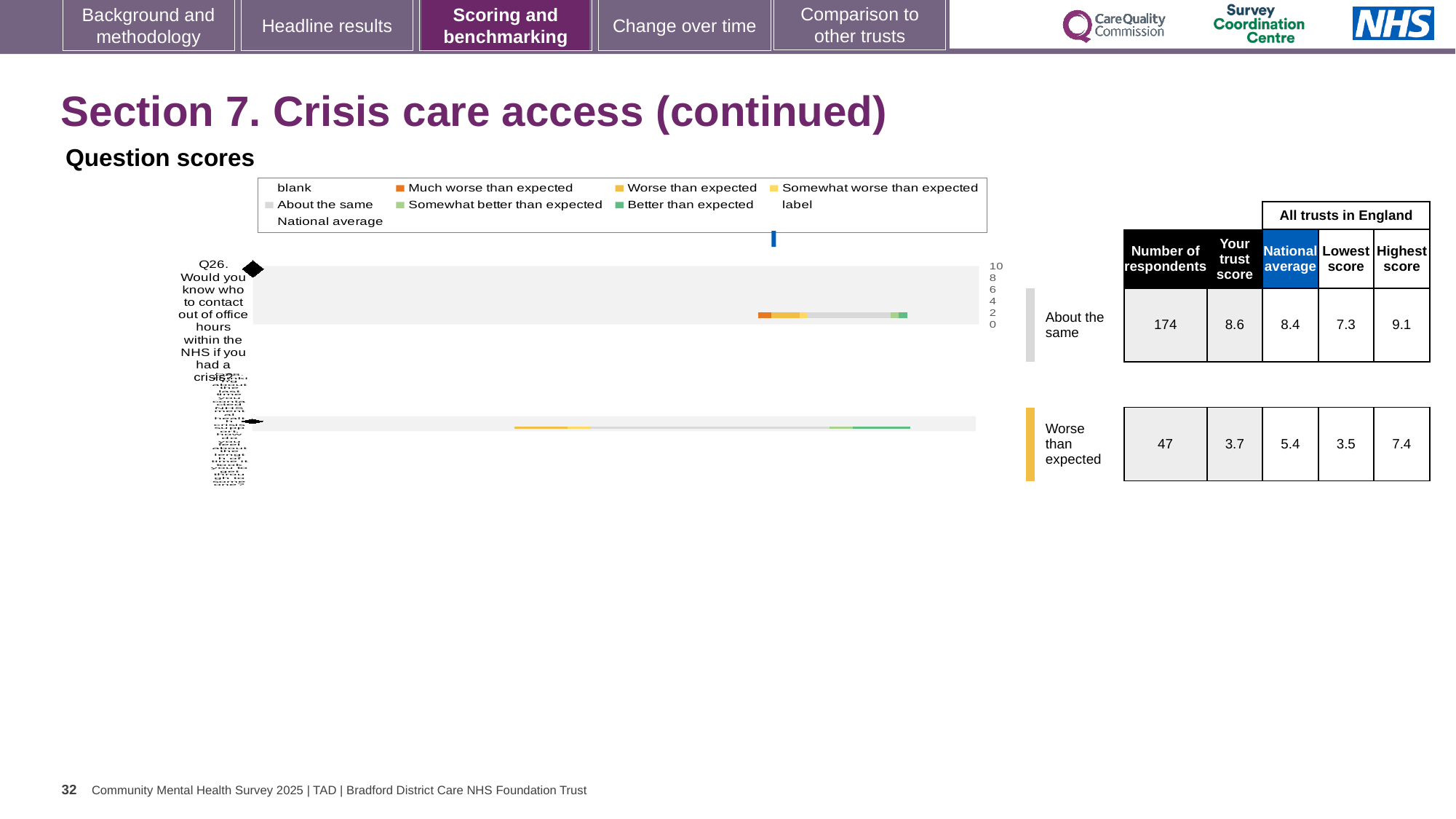
For Q26, which is larger: the trust score or the national average? the trust score What kind of chart is used to show the question scores on this slide? bar chart In the legend, what colour represents 'Much worse than expected'? orange What is the trust score for Q26 in the question scores chart? 8.6 What is the national average for Q26? 8.4 Which benchmark category is the second question row placed in? Worse than expected What is the highest score among all trusts in England for Q26? 9.1 How many questions are plotted as rows in the question scores chart? 2 What is the trust score for the second question row, which is rated 'Worse than expected'? 3.7 Which benchmark category is Q26 placed in? About the same What is the difference between the highest score and the lowest score for Q26? 1.8 What is the number of respondents for Q26 (Would you know who to contact out of office hours within the NHS if you had a crisis?)? 174